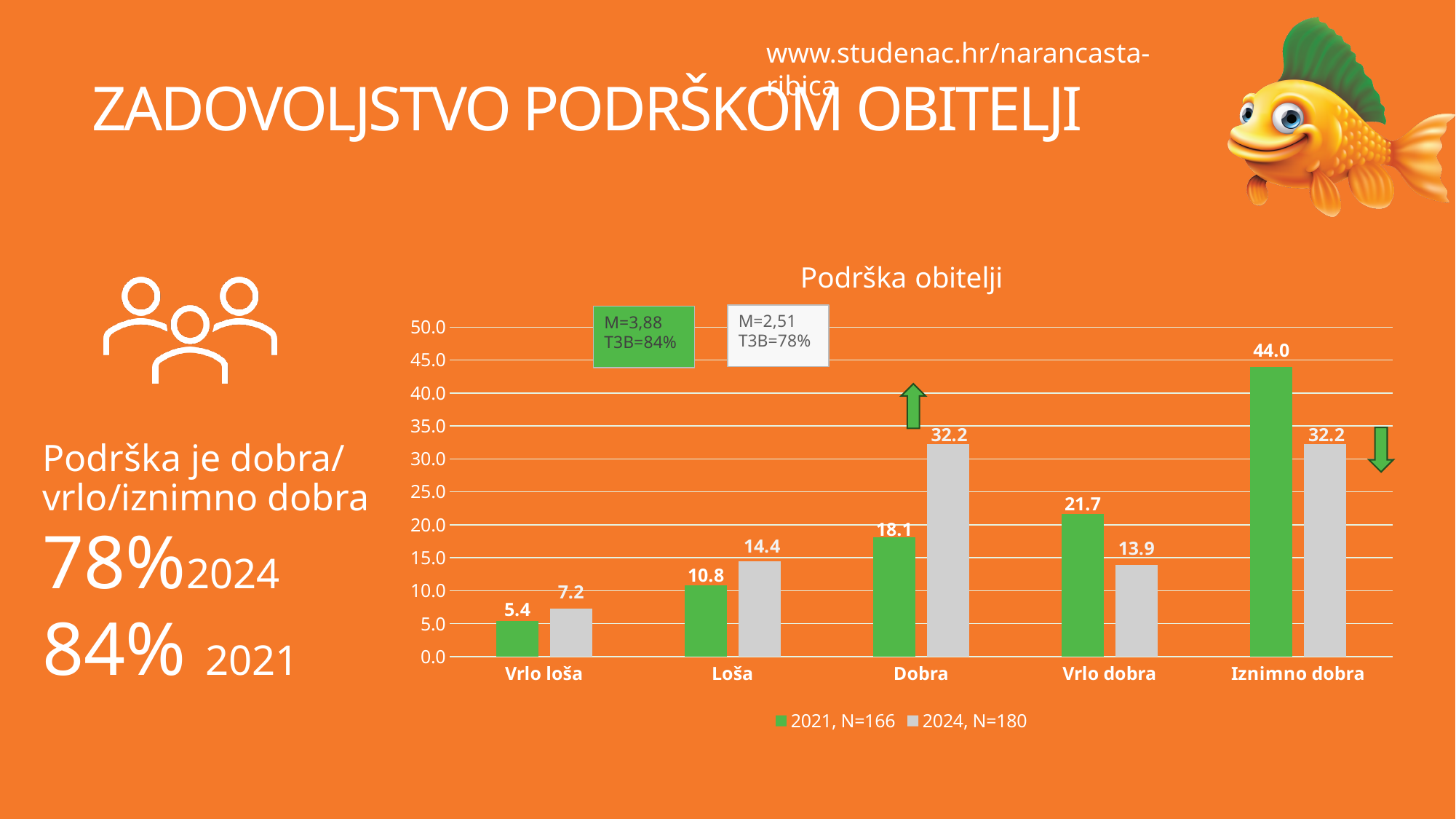
How many categories are shown on the x axis? 5 Which is larger for Loša: the 2021, N=166 value or the 2024, N=180 value? 2024, N=180 Is the value for Iznimno dobra in the 2021, N=166 series greater or less than 40.0? greater What is the difference between the 2021, N=166 and 2024, N=180 values for Iznimno dobra? 11.8 How many series does the legend list? 2 Which category has the lowest value in the 2024, N=180 series? Vrlo loša What is the title of the chart? Podrška obitelji What is the value for Vrlo dobra in the 2021, N=166 series? 21.7 What is the value for Vrlo loša in the 2024, N=180 series? 7.2 What kind of chart is shown? bar chart Which category has the highest value in the 2021, N=166 series? Iznimno dobra What is the value for Dobra in the 2024, N=180 series? 32.2